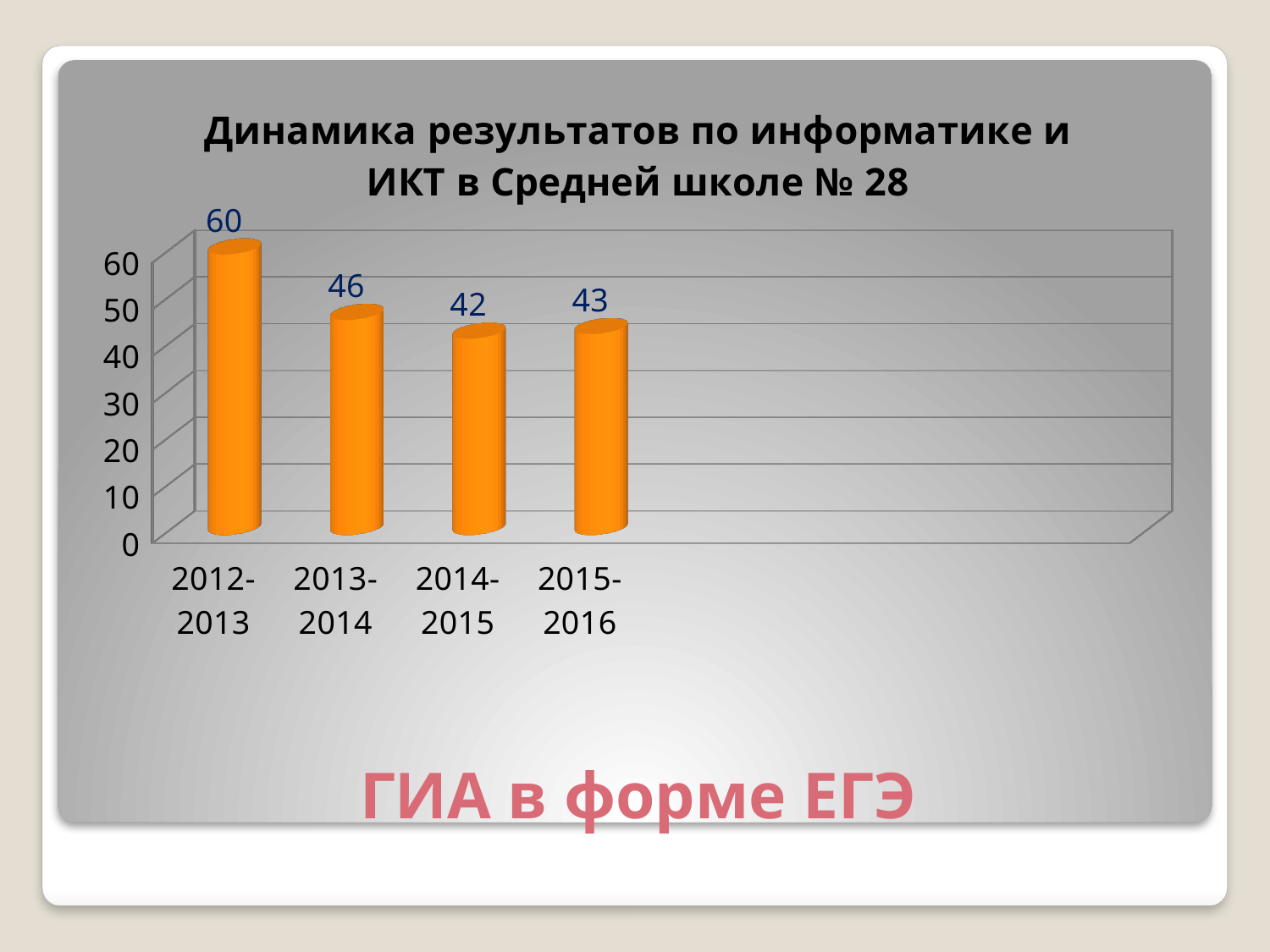
What is the value for 2014-2015? 42 What is the value for 2012-2013? 60 Which is larger, the value for 2013-2014 or the value for 2015-2016? 2013-2014 How many categories are shown on the x axis? 4 What is the difference between the values for 2012-2013 and 2013-2014? 14 What kind of chart is shown on the slide? bar chart What is the value for 2013-2014? 46 Which year has the lowest value? 2014-2015 What is the title of the chart? Динамика результатов по информатике и ИКТ в Средней школе № 28 Is the value for 2014-2015 greater or less than 50? less Which year has the highest value? 2012-2013 What is the value for 2015-2016? 43